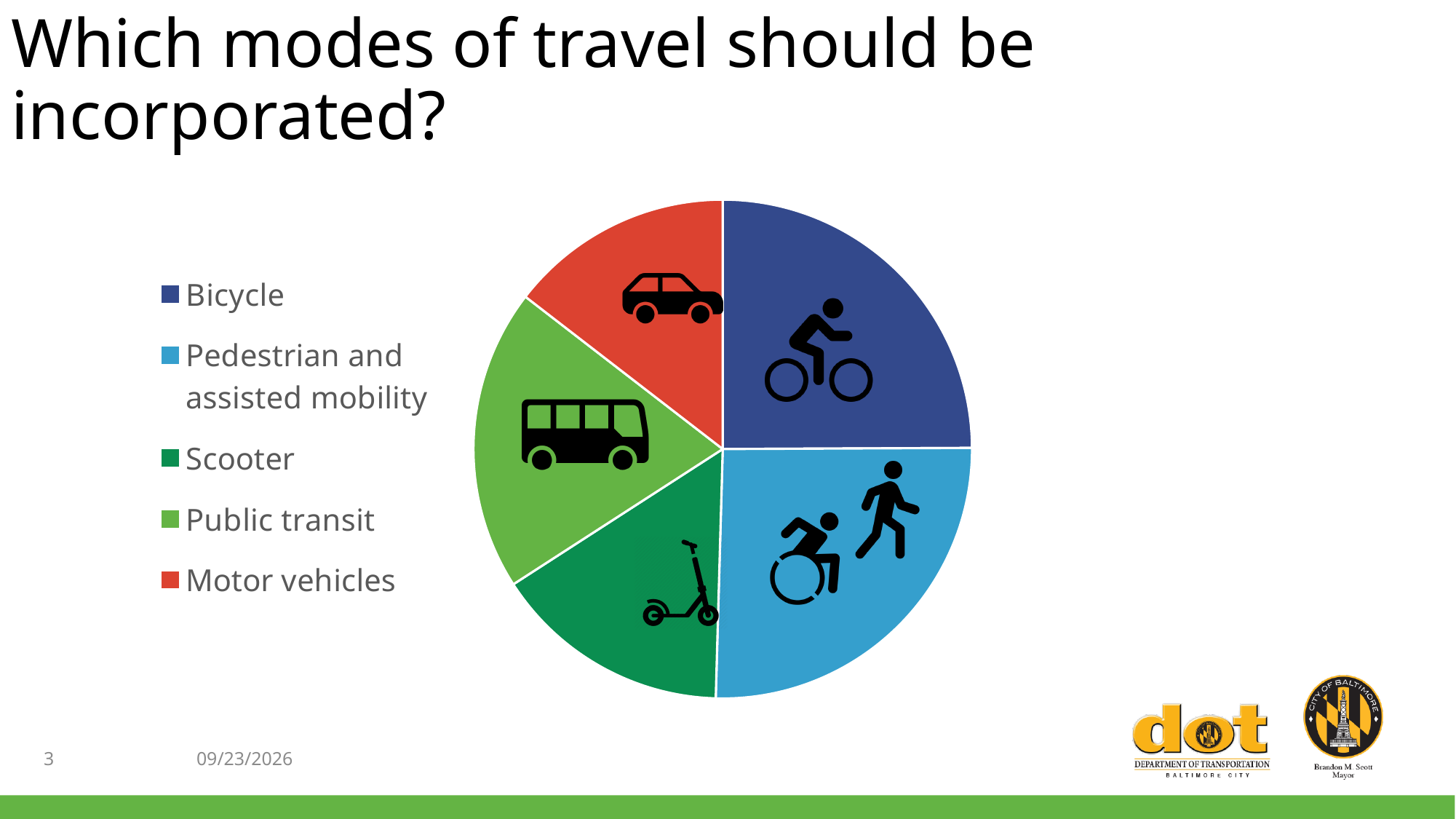
What is the title of the slide containing the pie chart? Which modes of travel should be incorporated? What colour is the Motor vehicles slice in the pie chart? Red Which slice is larger, Pedestrian and assisted mobility or Scooter? Pedestrian and assisted mobility What kind of chart is shown on the slide? Pie chart Which slice is larger, Pedestrian and assisted mobility or Motor vehicles? Pedestrian and assisted mobility How many slices does the pie chart have? 5 Which slice is larger, Bicycle or Public transit? Bicycle How many entries does the legend of the pie chart list? 5